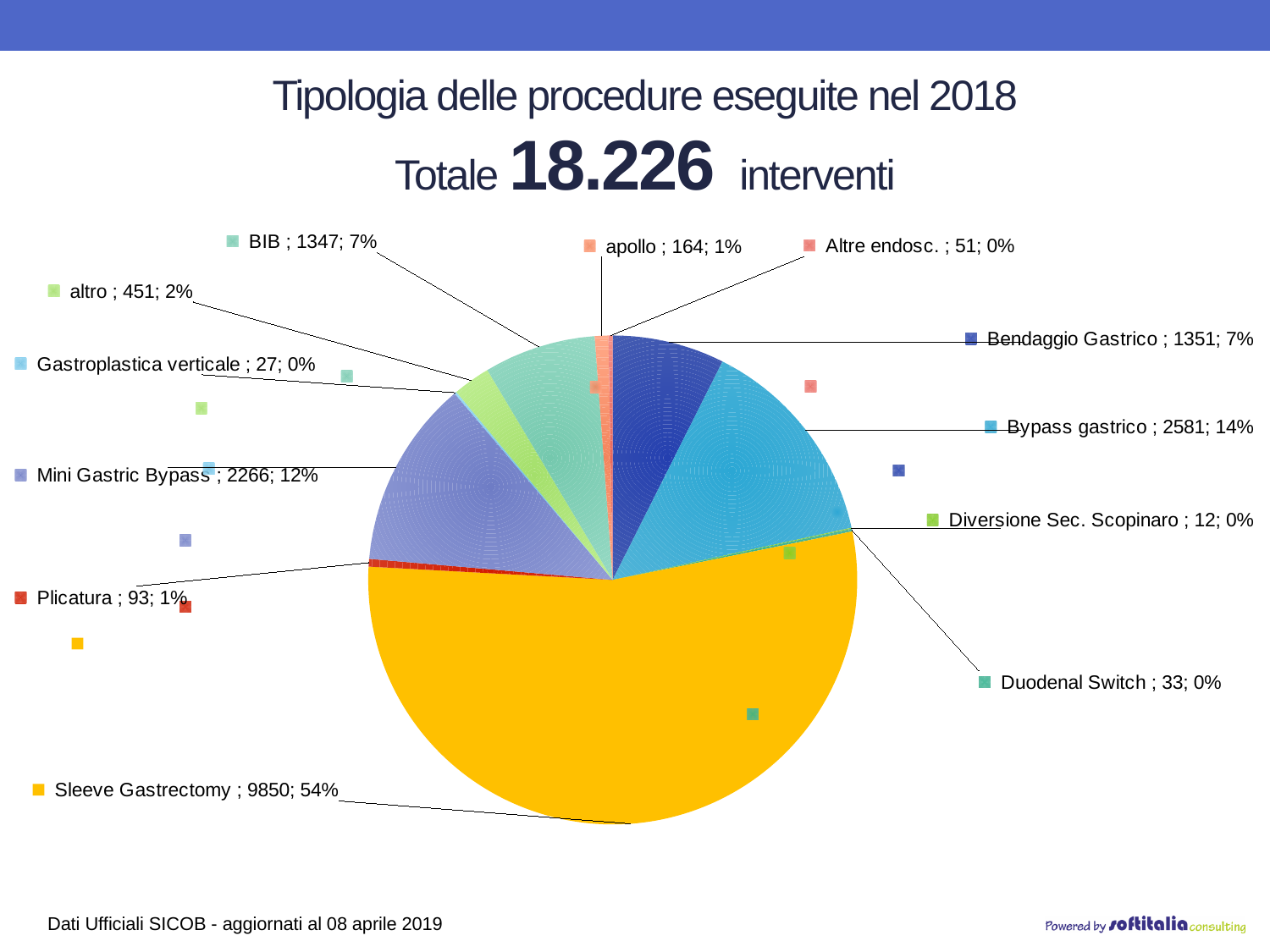
Which category has the smallest value in the pie chart? Diversione Sec. Scopinaro What is the value shown for Plicatura? 93 What is the difference between the values for Bypass gastrico and Mini Gastric Bypass? 315 Which category has the largest slice of the pie? Sleeve Gastrectomy What type of chart is shown on the slide? pie chart How many procedures are shown for Sleeve Gastrectomy? 9850 What total number of interventions is stated in the chart title? 18.226 What percentage is shown for Mini Gastric Bypass? 12% How many procedures are shown for Bypass gastrico? 2581 How many categories are shown in the pie chart? 12 What share of the pie does Sleeve Gastrectomy represent? 54% Which is larger, the value for BIB or the value for Bendaggio Gastrico? Bendaggio Gastrico